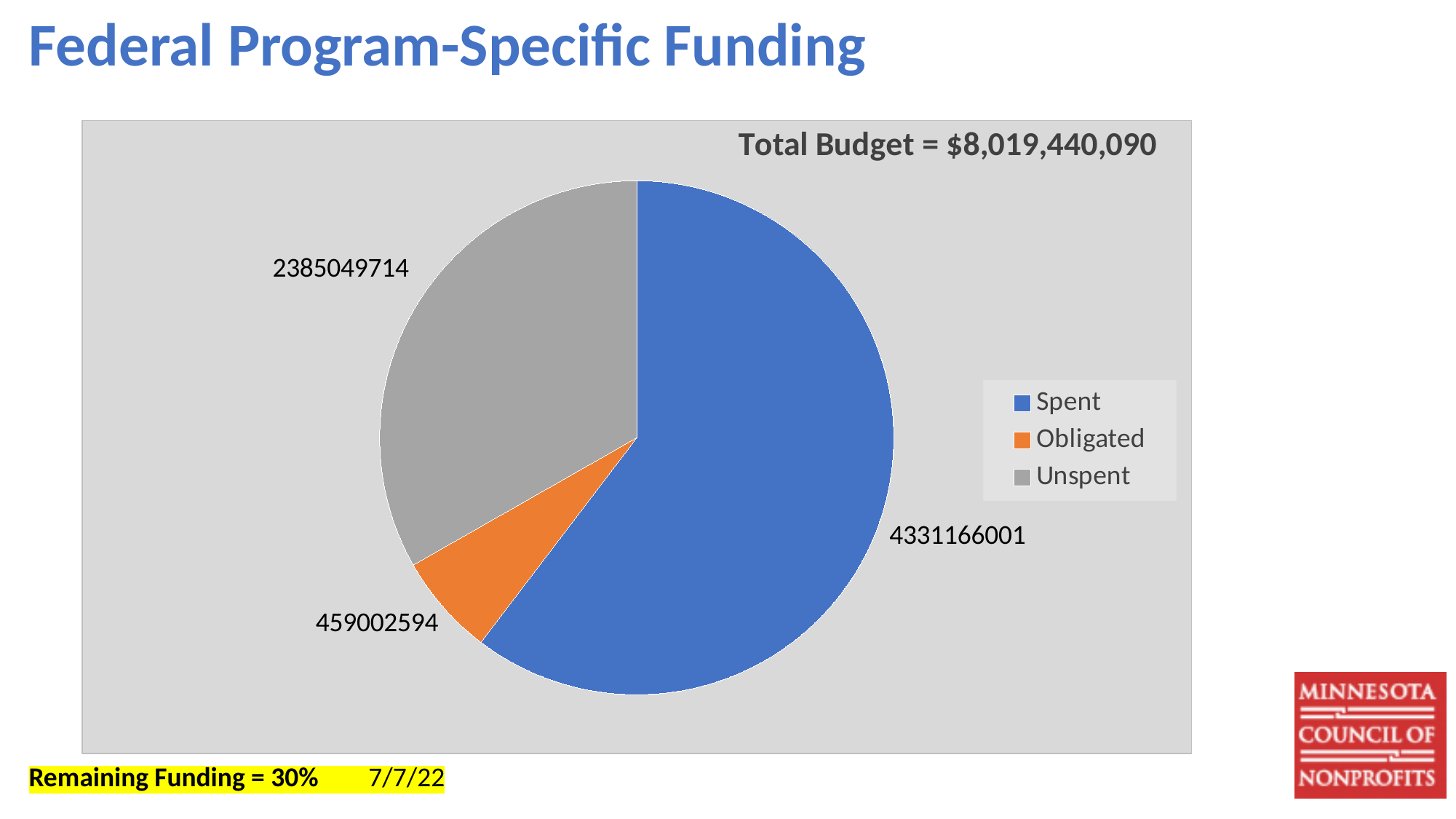
What is the difference between the Spent value and the Unspent value? 1946116287 How many slices does the pie chart have? 3 What is the difference between the Unspent value and the Obligated value? 1926047120 Which category has the smallest slice of the pie? Obligated What total budget is stated on the chart? $8,019,440,090 How many entries does the legend list? 3 What type of chart is shown on the slide? Pie chart What is the value of the Spent slice? 4331166001 What is the value of the Obligated slice? 459002594 What is the value of the Unspent slice? 2385049714 Which category has the largest slice of the pie? Spent Which is larger, the Unspent value or the Obligated value? Unspent